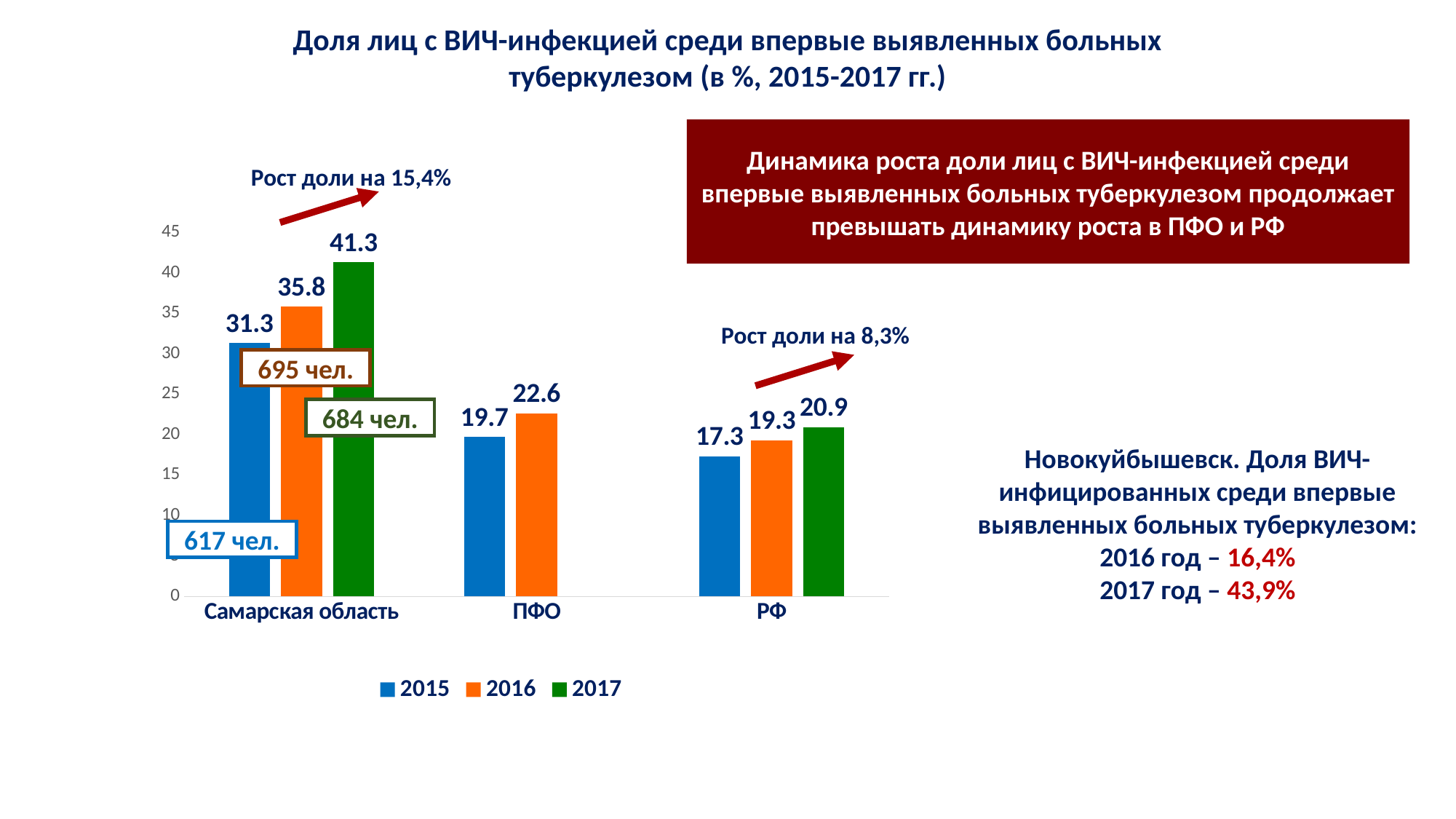
Do the values for РФ rise or fall from 2015 to 2017? Rise What kind of chart is shown on the slide? Bar chart What is the value for РФ in 2015? 17.3 Which is larger: the 2016 value for ПФО or the 2017 value for РФ? 2016 value for ПФО What is the value for ПФО in 2016? 22.6 What is the difference between the 2017 and 2015 values for Самарская область? 10 What is the difference between the 2016 values for Самарская область and РФ? 16.5 What is the value for Самарская область in 2017? 41.3 Which category has the highest value in 2017? Самарская область Which category has the lowest value in 2015? РФ How many categories are shown on the x axis? 3 How many series does the legend list? 3